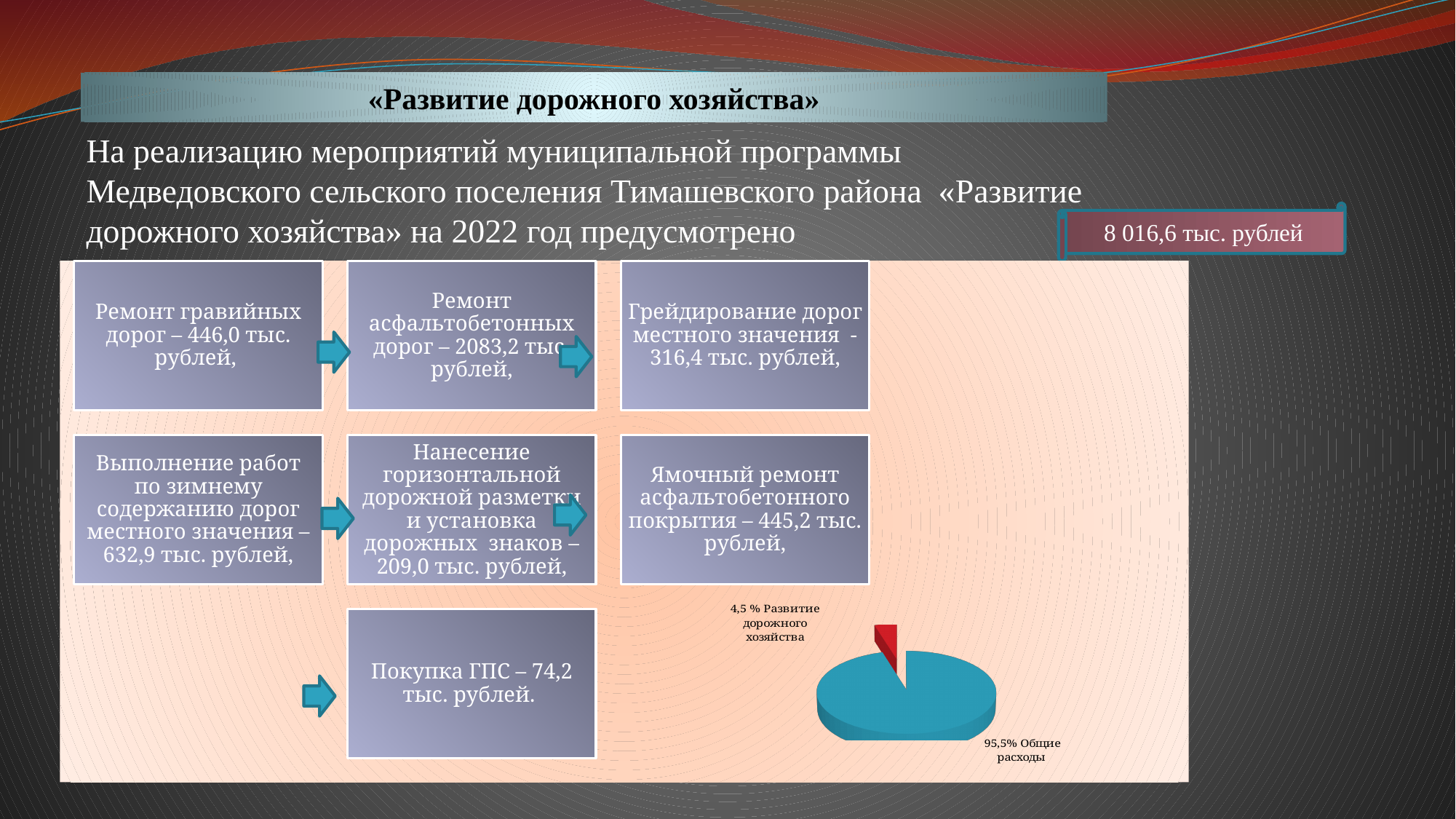
Which is larger in the pie chart: "Общие расходы" or "Развитие дорожного хозяйства"? Общие расходы What share of the pie chart is labelled "Общие расходы"? 95,5% Which slice of the pie chart is the smallest? Развитие дорожного хозяйства What share of the pie chart is labelled "Развитие дорожного хозяйства"? 4,5 % What colour is the "Развитие дорожного хозяйства" slice in the pie chart? red What kind of chart is shown on the slide? pie chart By how many percentage points does the "Общие расходы" share exceed the "Развитие дорожного хозяйства" share in the pie chart? 91 How many slices does the pie chart have? 2 Which slice of the pie chart is the largest? Общие расходы What colour is the "Общие расходы" slice in the pie chart? blue